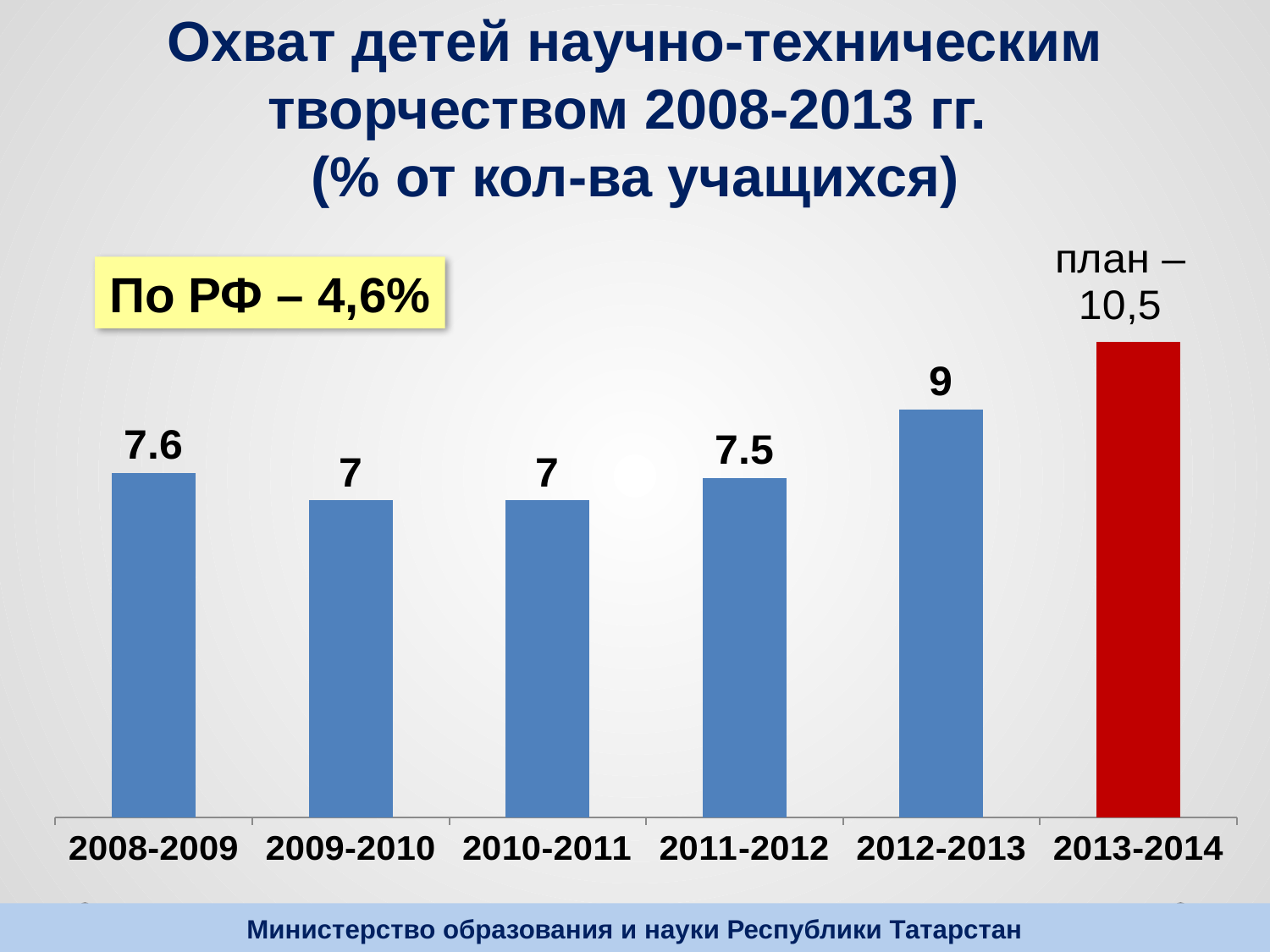
Which category has the highest bar? 2013-2014 What kind of chart is shown on the slide? bar chart What is the planned value shown for 2013-2014? 10,5 What is the difference between the values for 2012-2013 and 2011-2012? 1.5 Which is larger, the value for 2008-2009 or the value for 2009-2010? 2008-2009 Which category has the highest value among the blue bars (2008-2009 to 2012-2013)? 2012-2013 Do the values rise or fall from 2010-2011 to 2013-2014? rise How many categories are shown on the x axis? 6 What colour is the bar for 2013-2014? red What is the value for 2008-2009? 7.6 What is the value for 2011-2012? 7.5 What is the value for 2012-2013? 9